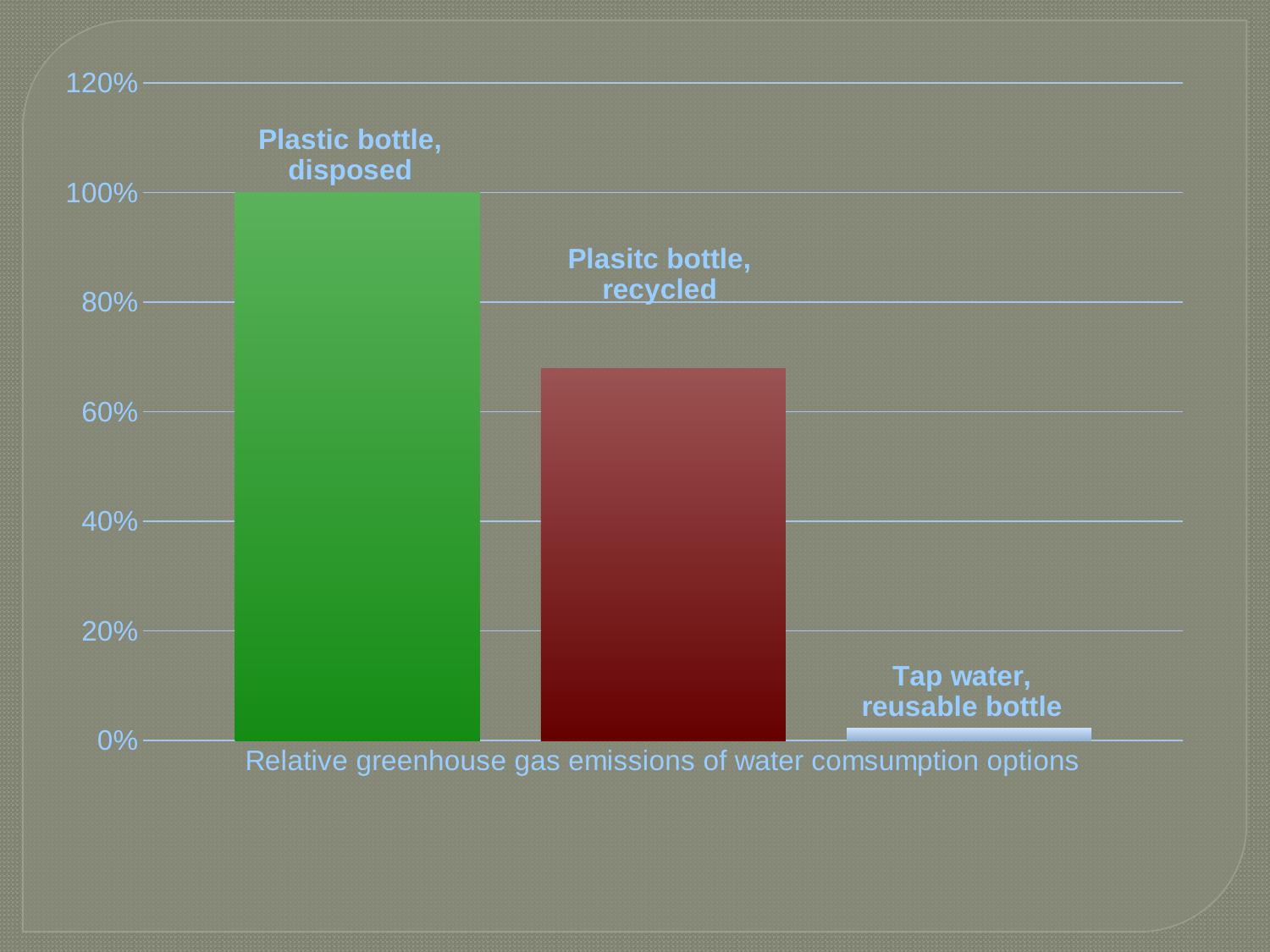
How many bars (categories) does the chart show? 3 Is the value for Tap water, reusable bottle greater or less than 20%? less Which category has the lowest value? Tap water, reusable bottle Is the value for Plasitc bottle, recycled greater or less than 80%? less Which category has the highest value? Plastic bottle, disposed What colour is the bar for Plastic bottle, disposed? green Which is larger: the value for Plastic bottle, disposed or for Plasitc bottle, recycled? Plastic bottle, disposed What is the text of the axis title shown below the bars? Relative greenhouse gas emissions of water comsumption options What kind of chart is shown on the slide? bar chart Do the values rise or fall from left to right across the bars? fall What is the value for Plastic bottle, disposed? 100% Is the value for Plasitc bottle, recycled greater or less than 60%? greater